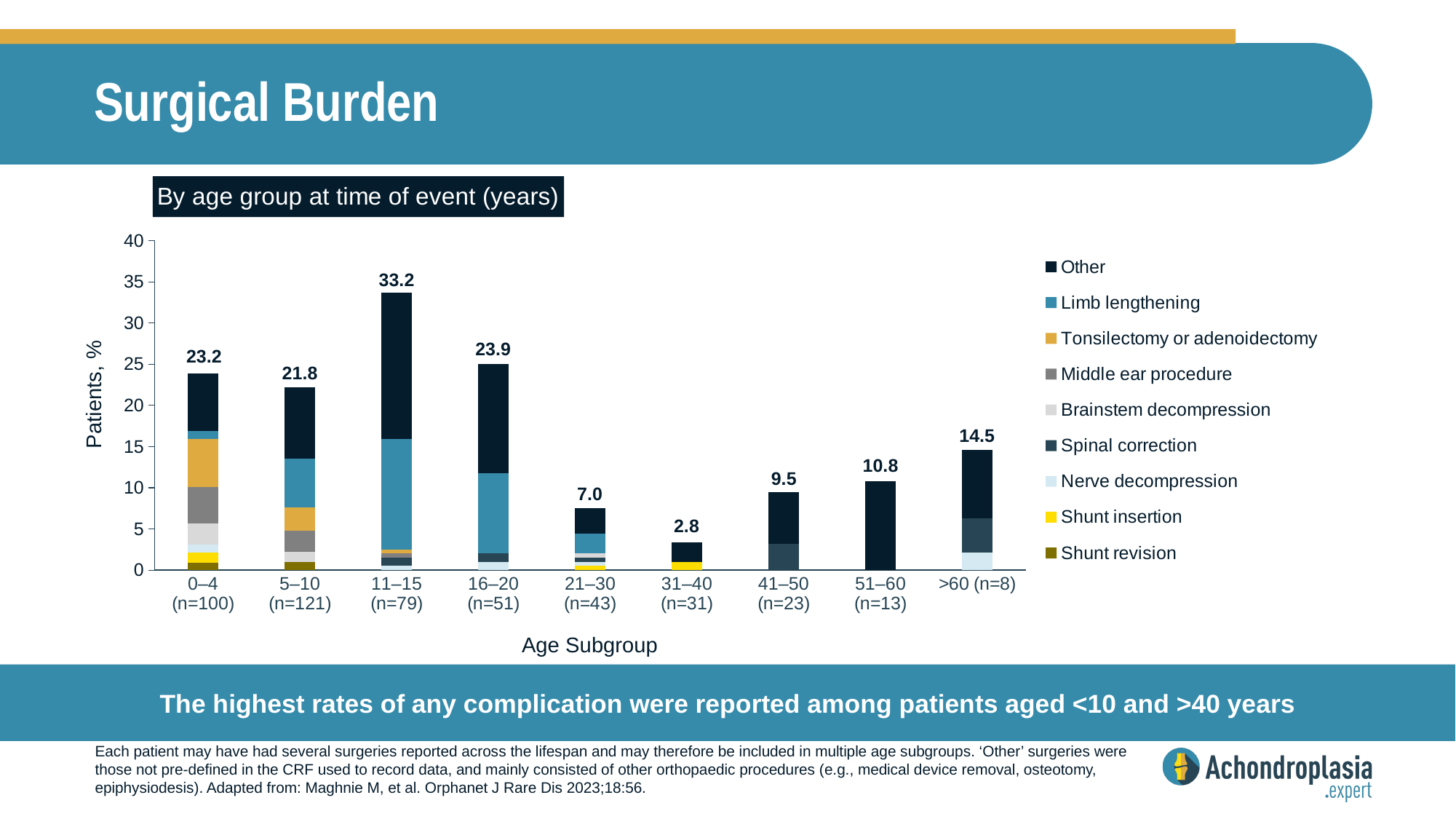
Which age subgroup has the lowest total percentage of patients? 31–40 (n=31) What is the label of the y axis? Patients, % What is the total percentage of patients labelled for the >60 (n=8) age subgroup? 14.5 How many age subgroups are shown on the x axis? 9 Which has a larger labelled total, the 0–4 age subgroup or the 5–10 age subgroup? 0–4 (n=100) Is the labelled total for the 16–20 age subgroup greater or less than 20? greater What is the difference between the labelled totals for the 11–15 and 0–4 age subgroups? 10.0 What is the difference between the labelled totals for the 51–60 and 41–50 age subgroups? 1.3 Which age subgroup has the highest total percentage of patients? 11–15 (n=79) What is the total percentage of patients labelled for the 11–15 (n=79) age subgroup? 33.2 What kind of chart is shown on the slide? Stacked bar chart How many surgery types does the legend list? 9